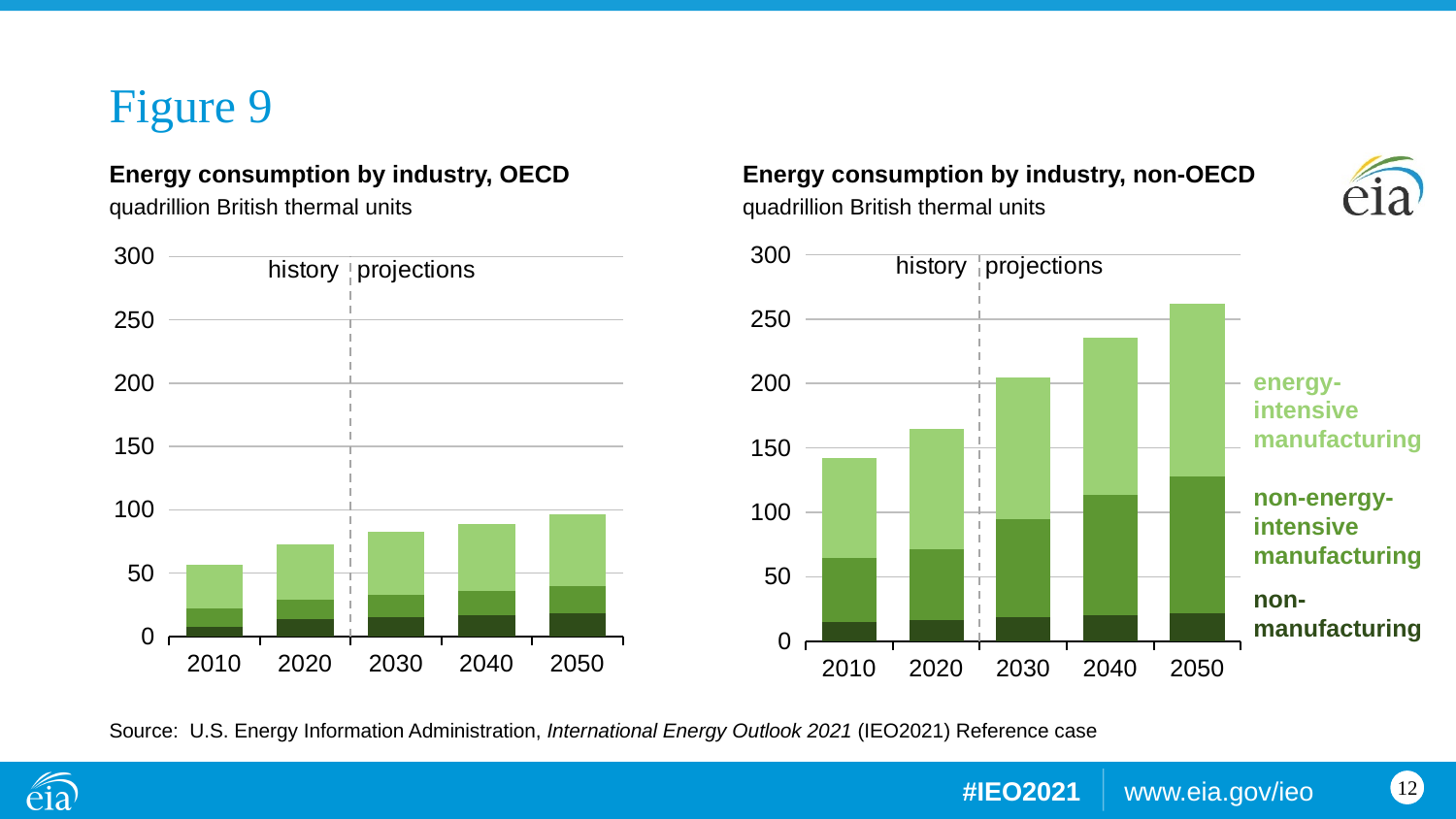
In the 'Energy consumption by industry, OECD' chart, which year has the lowest total energy consumption? 2010 In the 'Energy consumption by industry, non-OECD' chart, do total values rise or fall from 2010 to 2050? rise How many years are shown on the x axis of the 'Energy consumption by industry, non-OECD' chart? 5 In the 'Energy consumption by industry, non-OECD' chart, is the total value for 2050 greater or less than 250? greater In the 'Energy consumption by industry, OECD' chart, is the total value for 2030 greater or less than 100? less What kind of chart is the 'Energy consumption by industry, OECD' chart? stacked bar chart In the 'Energy consumption by industry, non-OECD' chart, which year has the highest total energy consumption? 2050 What unit is used on the y axis of both charts? quadrillion British thermal units How many series does the legend list for the 'Energy consumption by industry, non-OECD' chart? 3 Which is larger: the total energy consumption in 2050 in the OECD chart or in the non-OECD chart? non-OECD In the 'Energy consumption by industry, non-OECD' chart, which series is shown in the lightest green? energy-intensive manufacturing In the 'Energy consumption by industry, non-OECD' chart, is the total value for 2040 greater or less than 200? greater